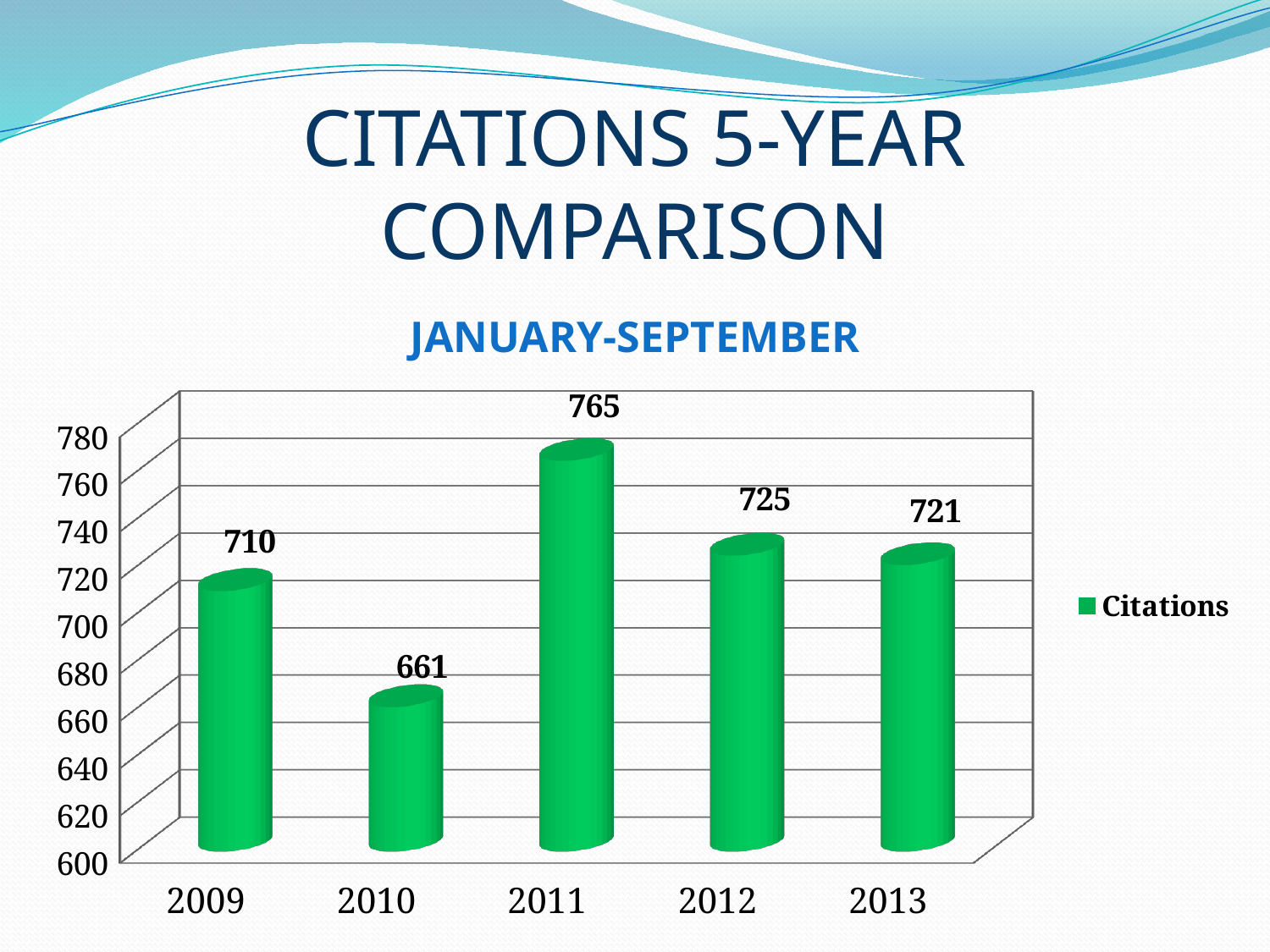
Is the value for 2009 greater or less than 700? greater What is the number of citations for 2010? 661 What is the difference in citations between 2012 and 2013? 4 What kind of chart is shown on the slide? Bar chart Which year has the highest number of citations? 2011 Which year has the lowest number of citations? 2010 What is the difference in citations between 2011 and 2010? 104 What is the number of citations for 2011? 765 How many years are shown on the chart? 5 What series does the legend list? Citations What is the number of citations for 2013? 721 Which year has more citations, 2009 or 2012? 2012